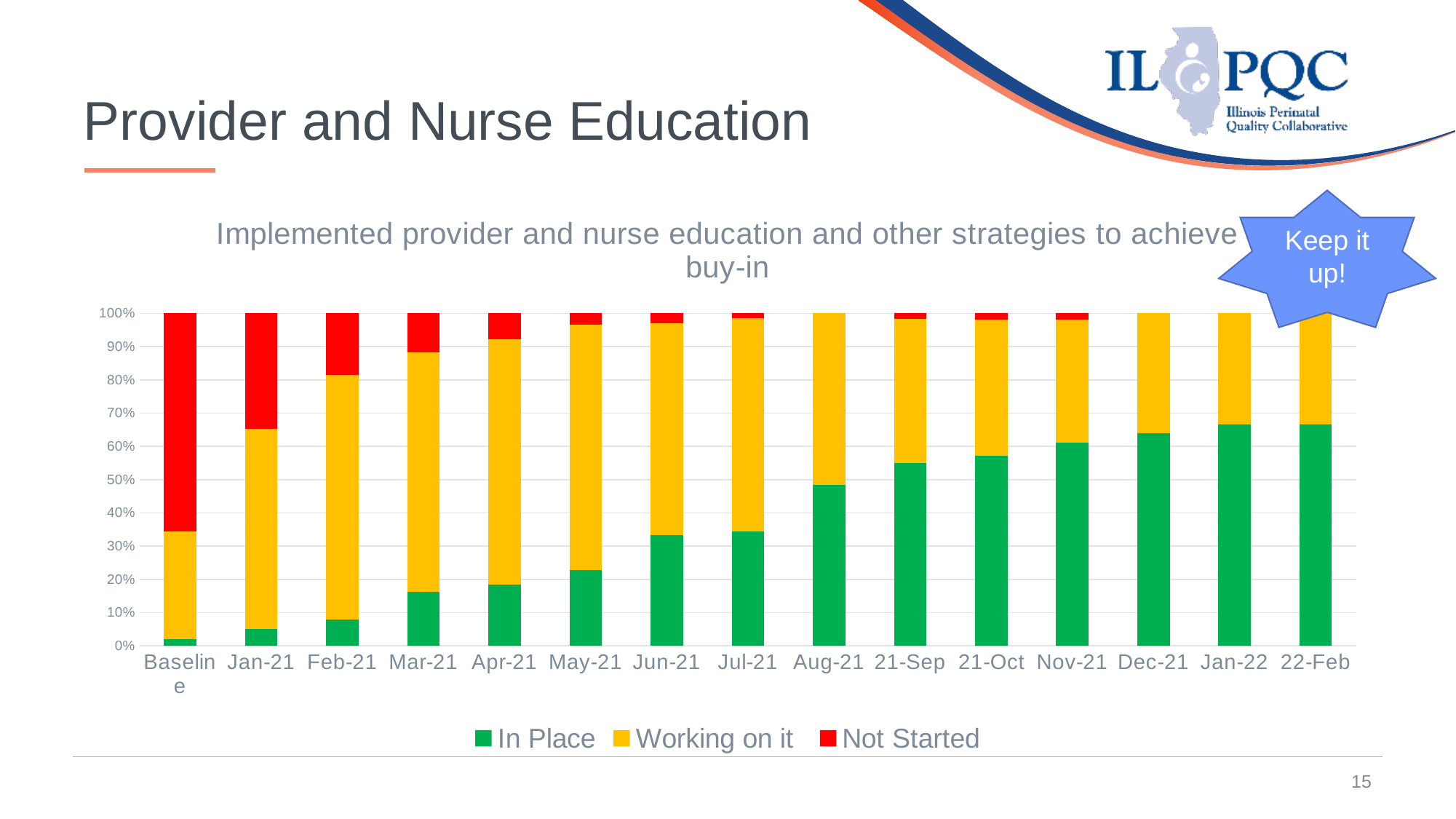
Is the In Place value for Aug-21 greater or less than 40%? greater What kind of chart is shown on the slide? Stacked bar chart Which category has the lowest In Place share? Baseline Which category has the largest Not Started share? Baseline Is the In Place value for Jan-22 greater or less than 60%? greater Which is larger, the In Place share for Jan-21 or for Nov-21? Nov-21 Does the In Place share generally rise or fall from Baseline to 22-Feb? rise Which series is shown in red in the legend? Not Started What is the title of the chart? Implemented provider and nurse education and other strategies to achieve buy-in Is the In Place value for Baseline greater or less than 10%? less How many series does the legend list? 3 How many time-period categories are shown along the x axis? 15